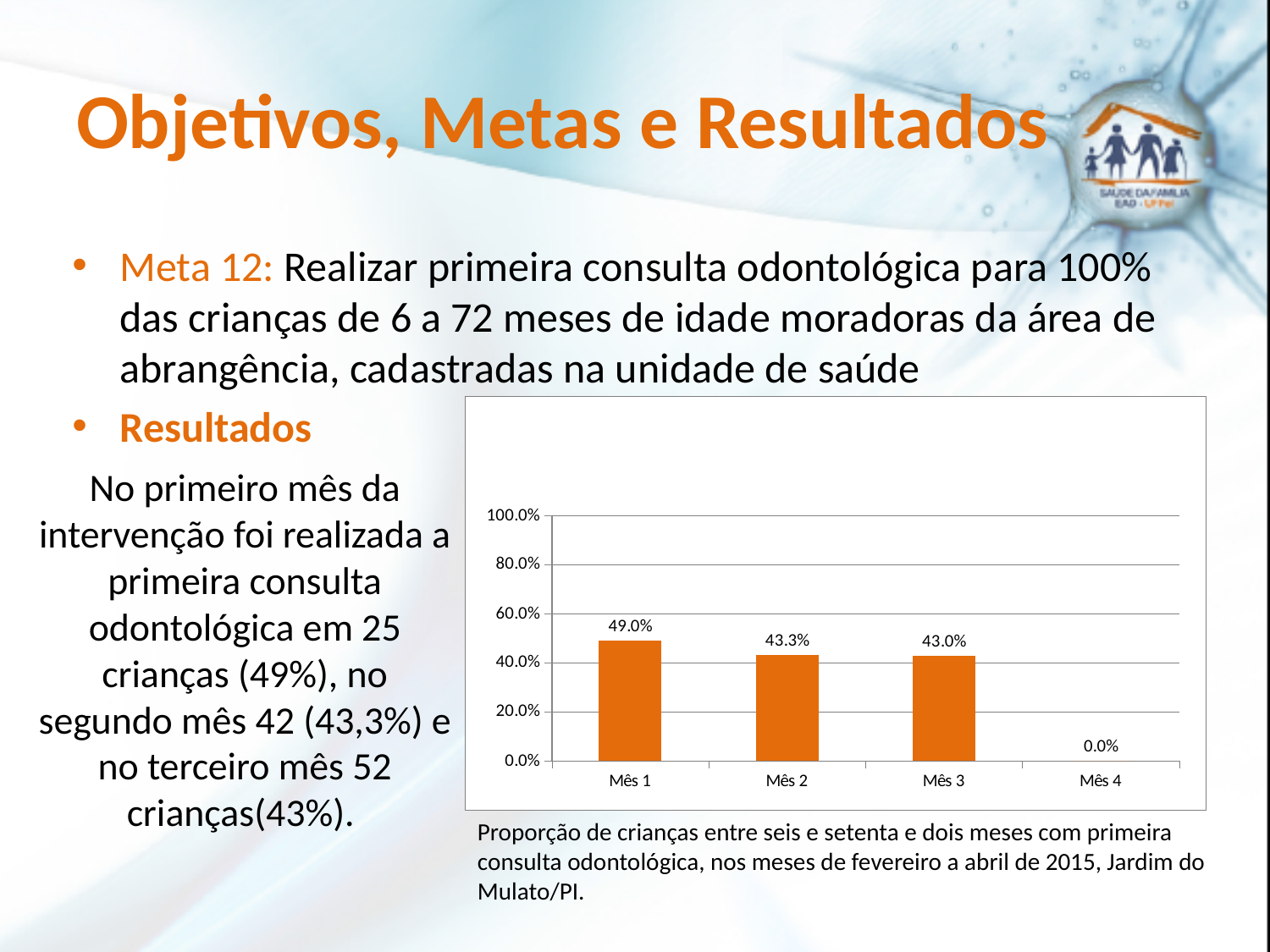
What is the value for Mês 3? 43.0% How many months are shown on the x axis? 4 Do the values rise or fall from Mês 1 to Mês 4? fall Which month has the lowest value? Mês 4 Which month has the highest value? Mês 1 What is the value for Mês 1? 49.0% What is the difference between the values for Mês 1 and Mês 2? 5.7% Which is larger, the value for Mês 1 or the value for Mês 3? Mês 1 Is the value for Mês 2 greater or less than 60.0%? less What kind of chart is shown on the slide? bar chart What is the value for Mês 4? 0.0% What is the value for Mês 2? 43.3%